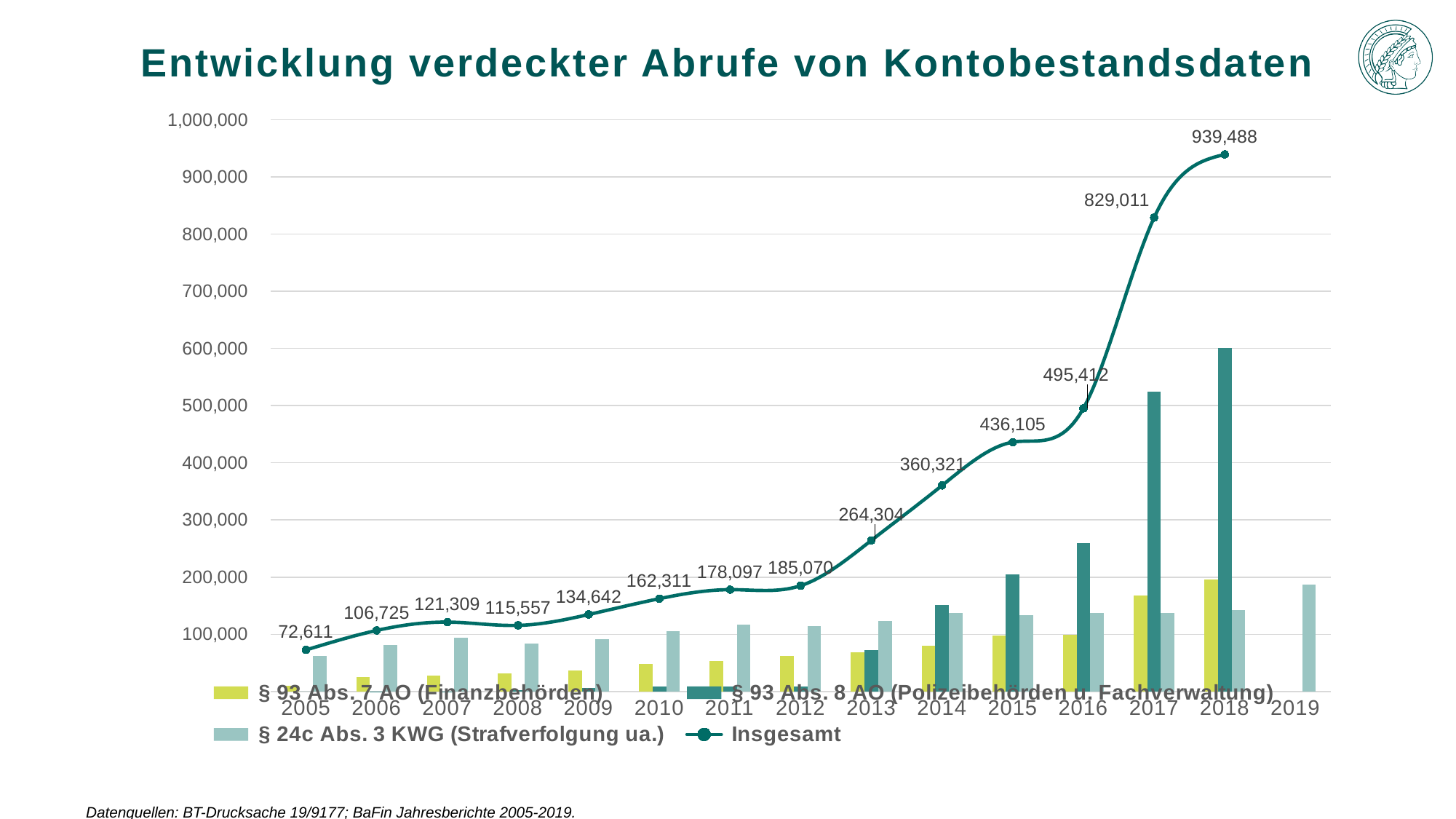
Which year has the larger Insgesamt value, 2007 or 2008? 2007 Is the value of the § 24c Abs. 3 KWG (Strafverfolgung ua.) bar for 2019 greater or less than 100,000? greater How many years are shown on the x axis? 15 Does the Insgesamt line generally rise or fall from 2005 to 2018? rise By how much did the Insgesamt value increase from 2017 to 2018? 110,477 In which year does the Insgesamt line reach its highest labelled value? 2018 How many series does the legend list? 4 In which year does the Insgesamt line have its lowest labelled value? 2005 What is the value of the Insgesamt line for 2018? 939,488 What is the value of the Insgesamt line for 2013? 264,304 Is the value of the § 93 Abs. 8 AO (Polizeibehörden u. Fachverwaltung) bar for 2018 greater or less than 500,000? greater What is the value of the Insgesamt line for 2005? 72,611